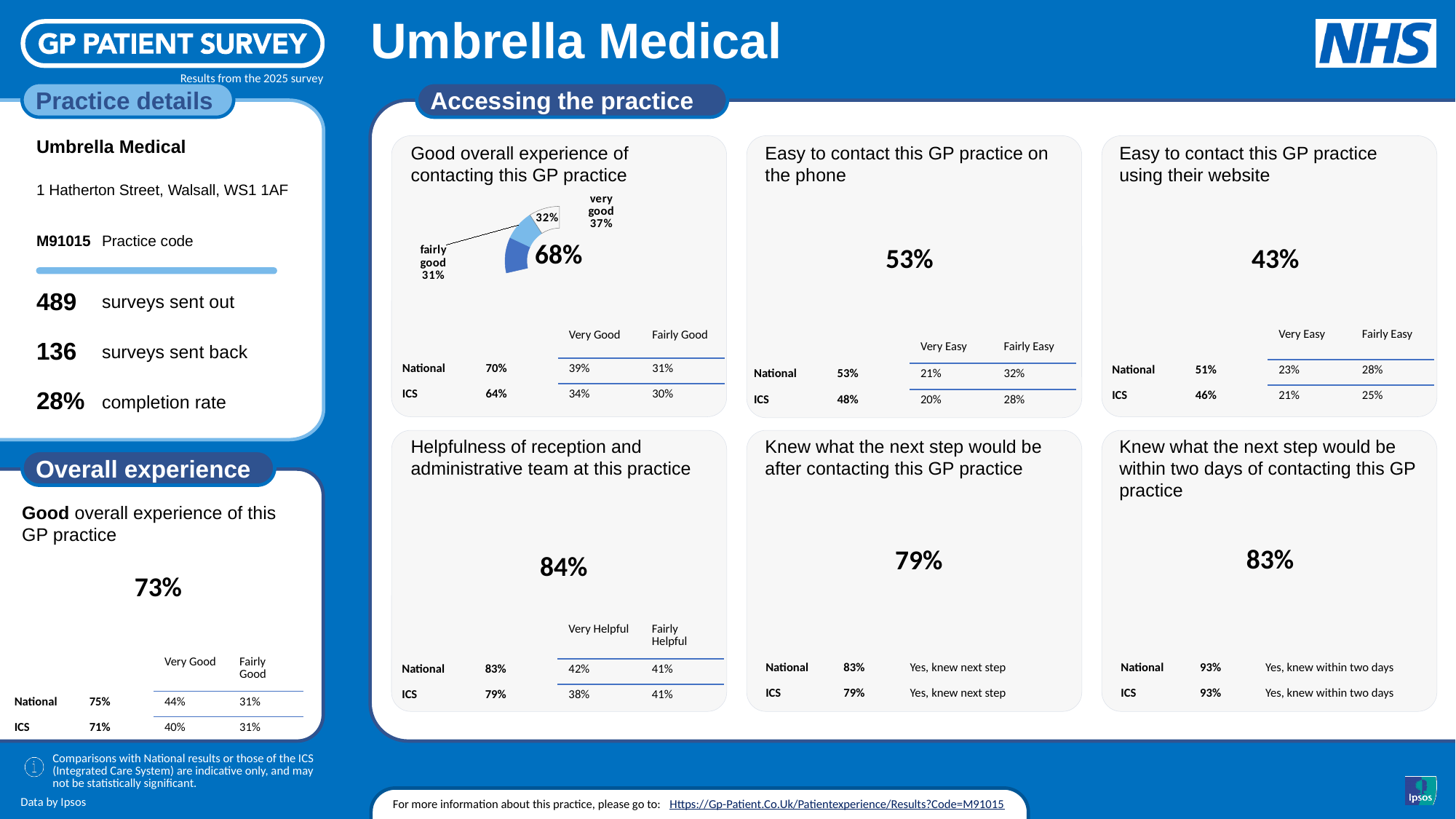
In the 'Good overall experience of contacting this GP practice' chart, what percentage is labelled 'fairly good'? 31% In the 'Good overall experience of contacting this GP practice' chart, which labelled segment has the highest percentage? very good What value is printed in the centre of the 'Good overall experience of contacting this GP practice' doughnut chart? 68% In the 'Good overall experience of contacting this GP practice' chart, what is the difference between the 'very good' and 'fairly good' percentages? 6 percentage points In the 'Good overall experience of contacting this GP practice' chart, what percentage is shown on the unlabelled third segment? 32% What kind of chart is shown in the 'Good overall experience of contacting this GP practice' panel? doughnut chart Below the 'Good overall experience of contacting this GP practice' chart, what is the National overall figure? 70% In the 'Good overall experience of contacting this GP practice' chart, what percentage is labelled 'very good'? 37% How many segments does the 'Good overall experience of contacting this GP practice' doughnut chart have? 3 In the 'Good overall experience of contacting this GP practice' chart, what do the 'very good' and 'fairly good' segments add up to? 68% What is the title of the panel containing the doughnut chart? Good overall experience of contacting this GP practice In the 'Good overall experience of contacting this GP practice' chart, which is larger: 'very good' or 'fairly good'? very good